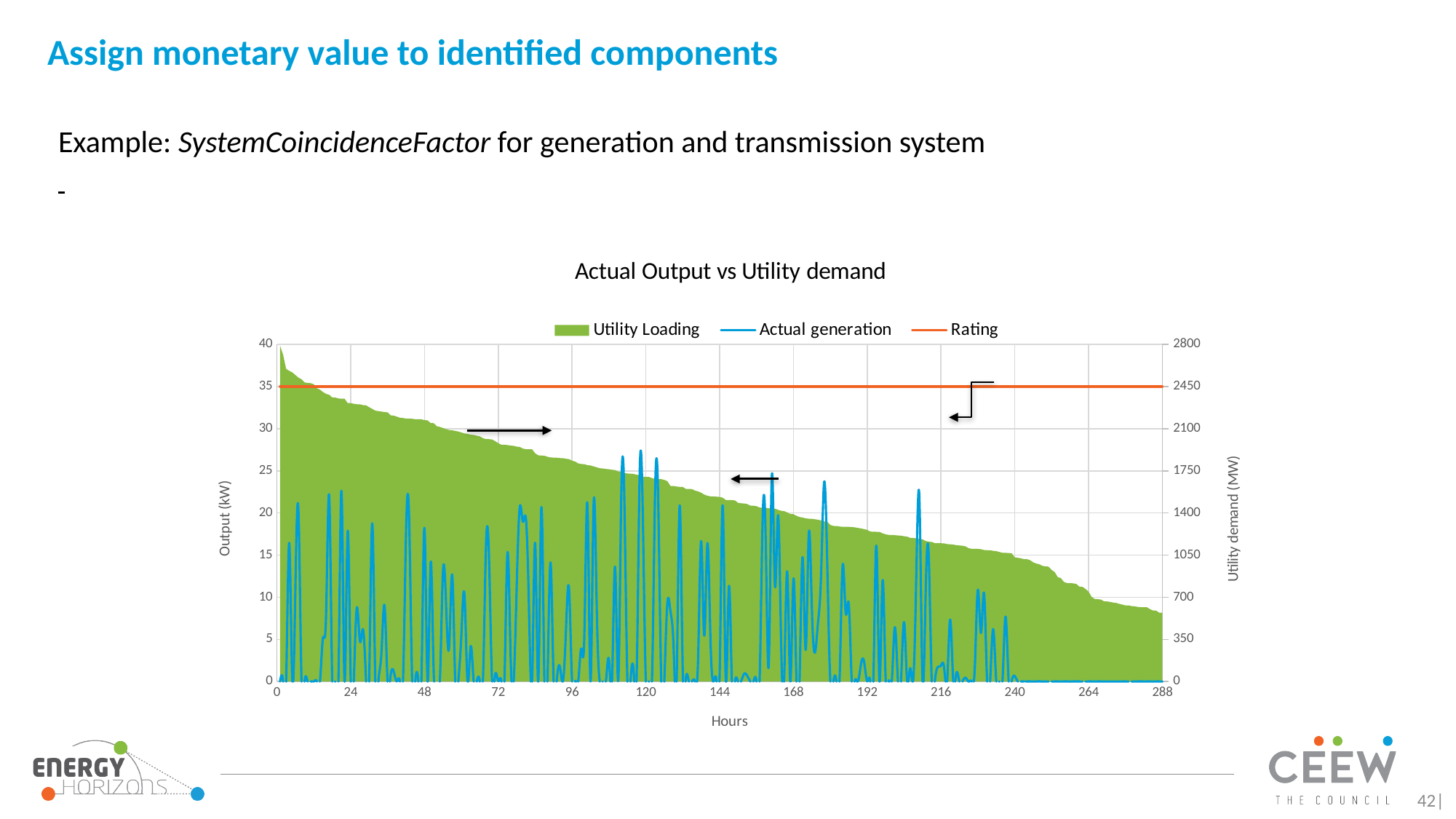
Is the highest peak of the Actual generation series greater or less than 30 kW? less Is the Utility Loading value at hour 288 greater or less than 700 MW on the right axis? less What is the title of the chart? Actual Output vs Utility demand How many series does the chart legend list? 3 What is the label of the x axis? Hours Is the Rating line greater or less than 30 on the Output (kW) axis? greater What is the highest value shown on the right-hand Utility demand (MW) axis? 2800 Does the Utility Loading series rise or fall as hours increase along the x axis? fall